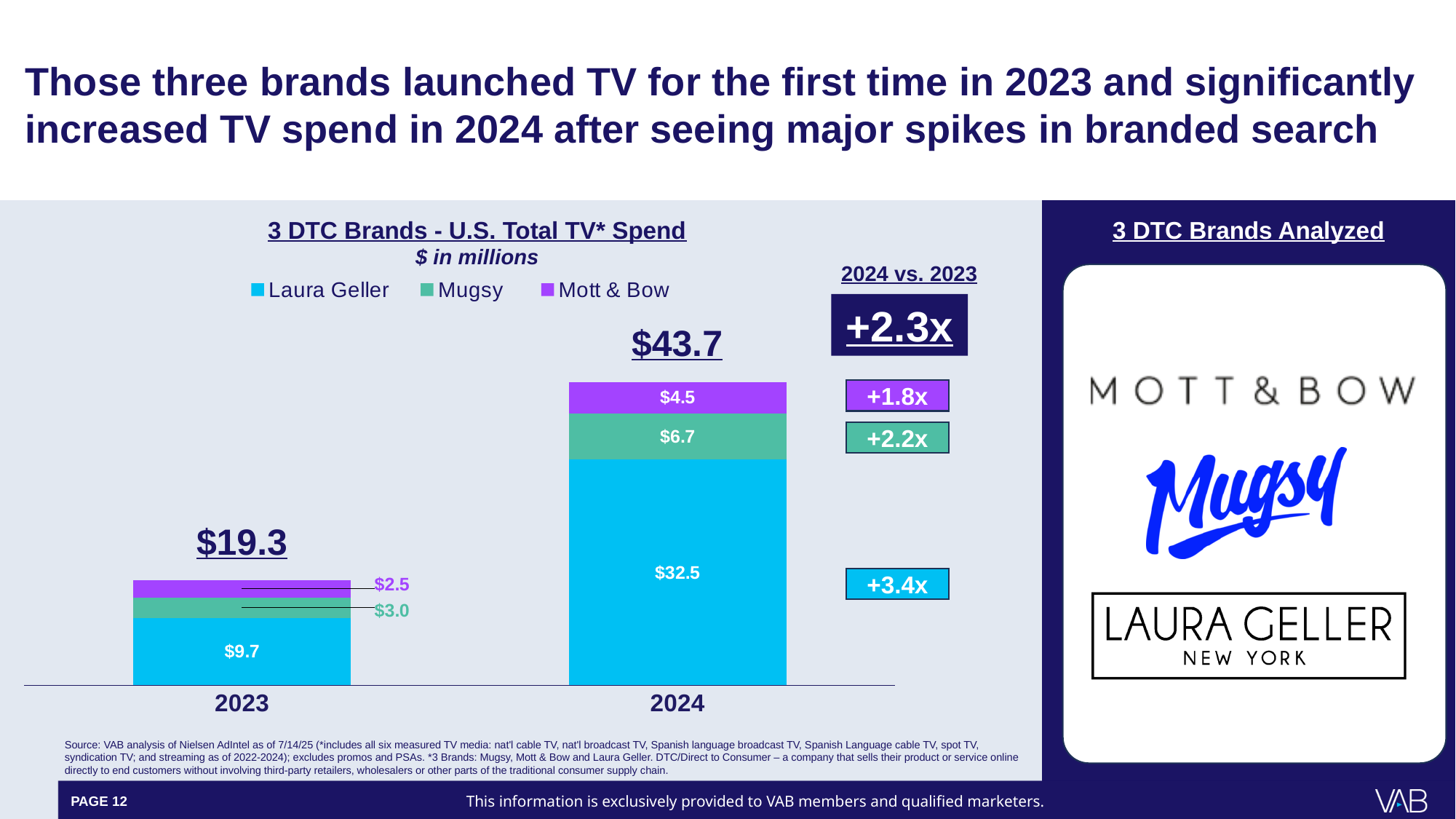
By what multiple did total TV spend change from 2023 to 2024, according to the slide? +2.3x What was Mugsy's U.S. total TV spend in 2023? $3.0 What was Mott & Bow's U.S. total TV spend in 2024? $4.5 How much more did Laura Geller spend on TV in 2024 than in 2023? $22.8 How many series does the legend list? 3 Which brand had the lowest TV spend in 2023? Mott & Bow Which brand had the highest TV spend in 2024? Laura Geller Which was larger in 2024: Mugsy's TV spend or Mott & Bow's TV spend? Mugsy What is the total TV spend across the three brands in 2023? $19.3 What was Laura Geller's U.S. total TV spend in 2024? $32.5 What kind of chart is shown? Stacked bar chart What is the total TV spend across the three brands in 2024? $43.7